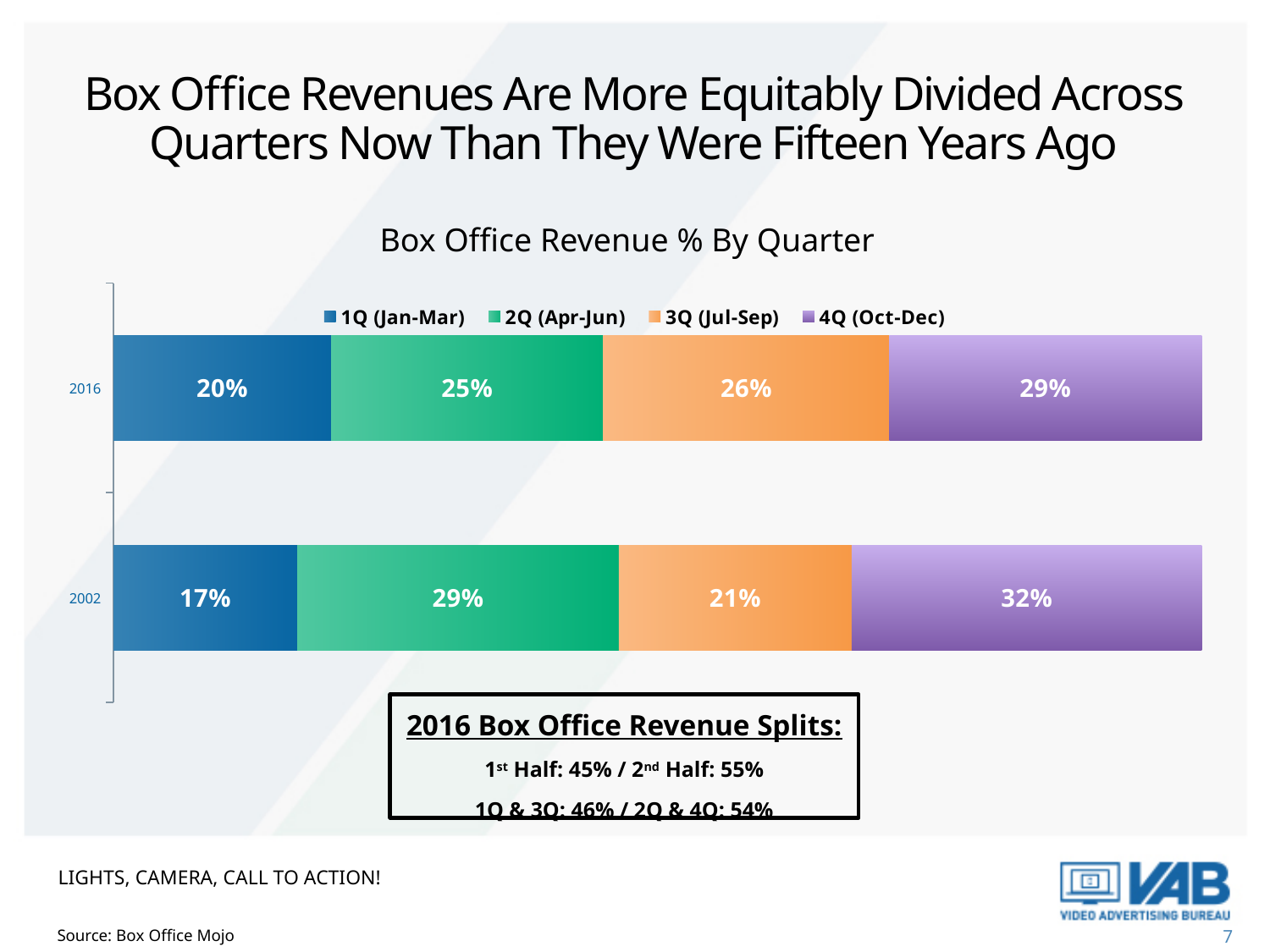
What is the 4Q (Oct-Dec) share of box office revenue in 2002? 32% What kind of chart is shown on the slide? Stacked bar chart What is the difference between the 4Q (Oct-Dec) share in 2002 and in 2016? 3% How many years (bars) are shown in the chart? 2 How many series does the legend list? 4 What is the title of the chart? Box Office Revenue % By Quarter What is the 1Q (Jan-Mar) share of box office revenue in 2016? 20% Which year had a larger 2Q (Apr-Jun) share of box office revenue, 2016 or 2002? 2002 Which quarter had the largest share of box office revenue in 2002? 4Q (Oct-Dec) What is the 3Q (Jul-Sep) share of box office revenue in 2016? 26% What is the 2Q (Apr-Jun) share of box office revenue in 2002? 29% Which quarter had the smallest share of box office revenue in 2016? 1Q (Jan-Mar)